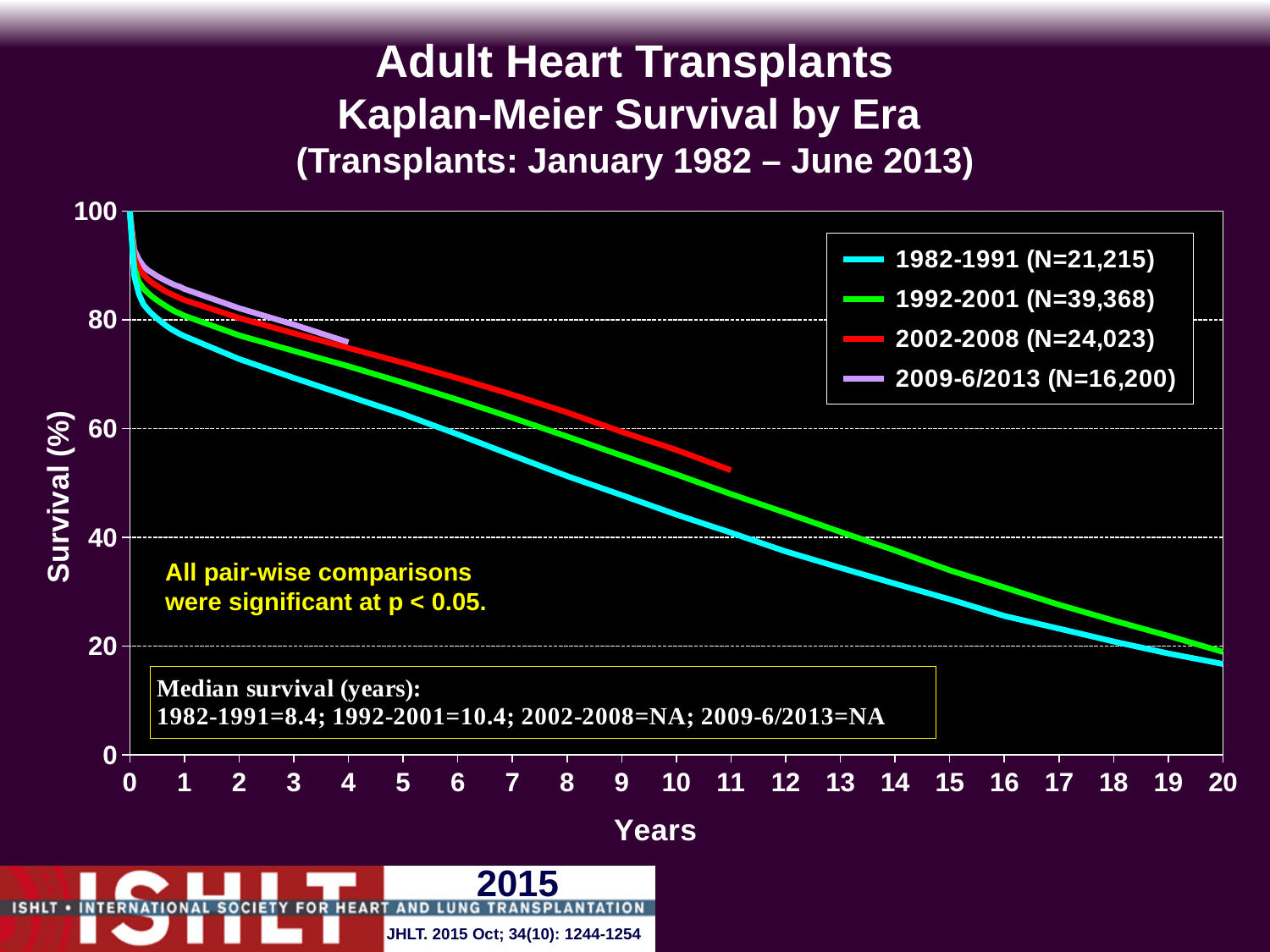
Is the survival value for the 2002-2008 era at 10 years greater or less than 40? greater What kind of chart is shown on the slide? line chart What is the median survival in years for the 1992-2001 era? 10.4 Is the survival value for the 1982-1991 era at 10 years greater or less than 60? less Do the survival curves rise or fall as years increase? fall Which era has the lowest survival curve across the years shown? 1982-1991 What is the median survival in years for the 1982-1991 era? 8.4 How many transplants (N) are in the 2009-6/2013 era according to the legend? 16,200 How many series does the legend list? 4 What is the difference in median survival (years) between the 1992-2001 era and the 1982-1991 era? 2.0 At 5 years, which era has higher survival: 1982-1991 or 1992-2001? 1992-2001 Which era's curve is drawn in red? 2002-2008